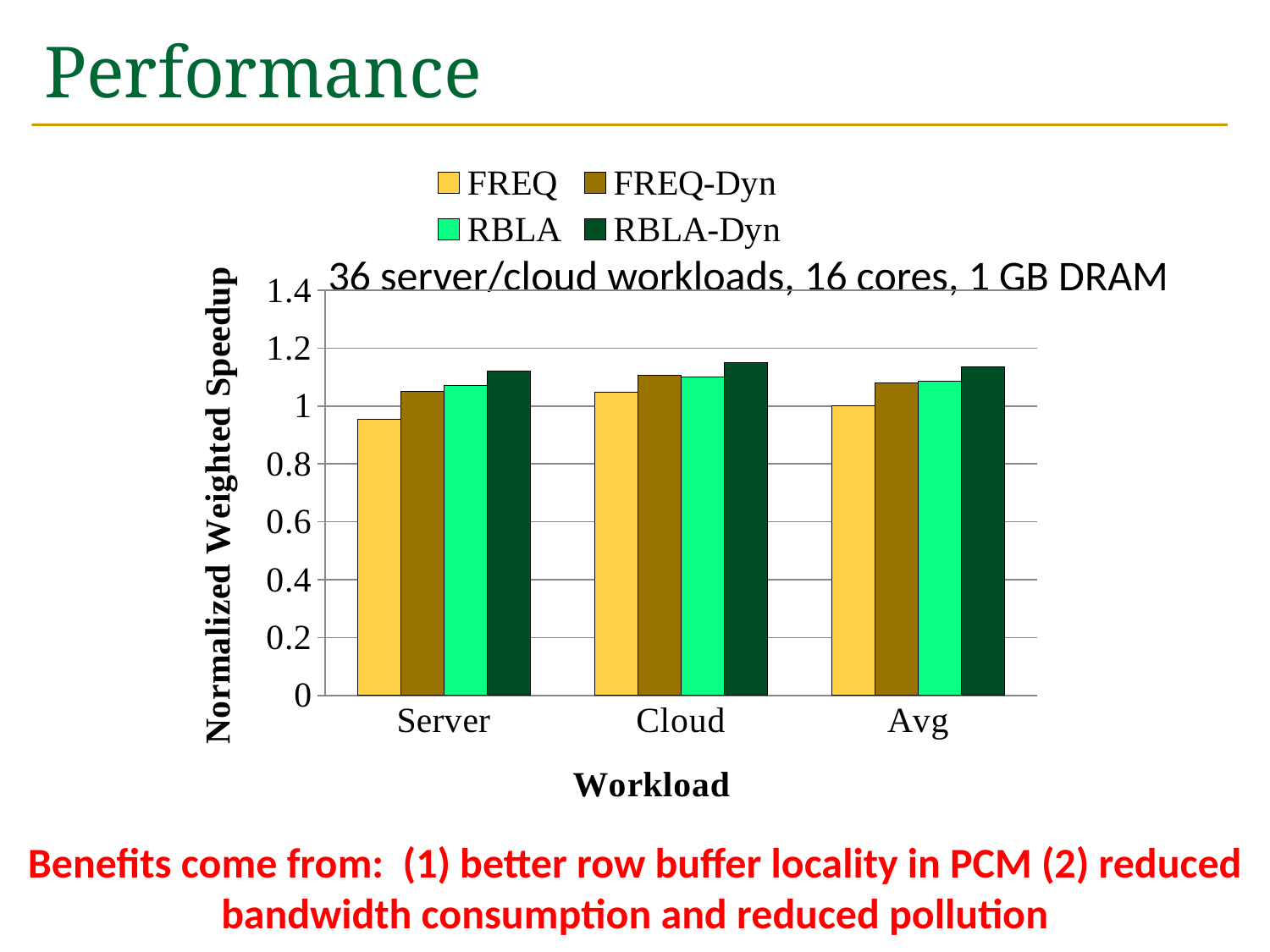
What kind of chart is shown on the slide? bar chart How many series does the legend list? 4 Which series has the lowest bar for the Avg workload? FREQ Which series has the highest bar for the Cloud workload? RBLA-Dyn Which series has the lowest bar for the Server workload? FREQ How many workload categories are shown on the x axis? 3 Is the FREQ value for Server greater or less than 1? less Is the RBLA-Dyn value for Cloud greater or less than 1? greater For the Server workload, which is larger: the FREQ bar or the RBLA-Dyn bar? RBLA-Dyn Which series has the highest bar for the Server workload? RBLA-Dyn Is the RBLA-Dyn value for Avg greater or less than 1.2? less What is the label of the y axis? Normalized Weighted Speedup